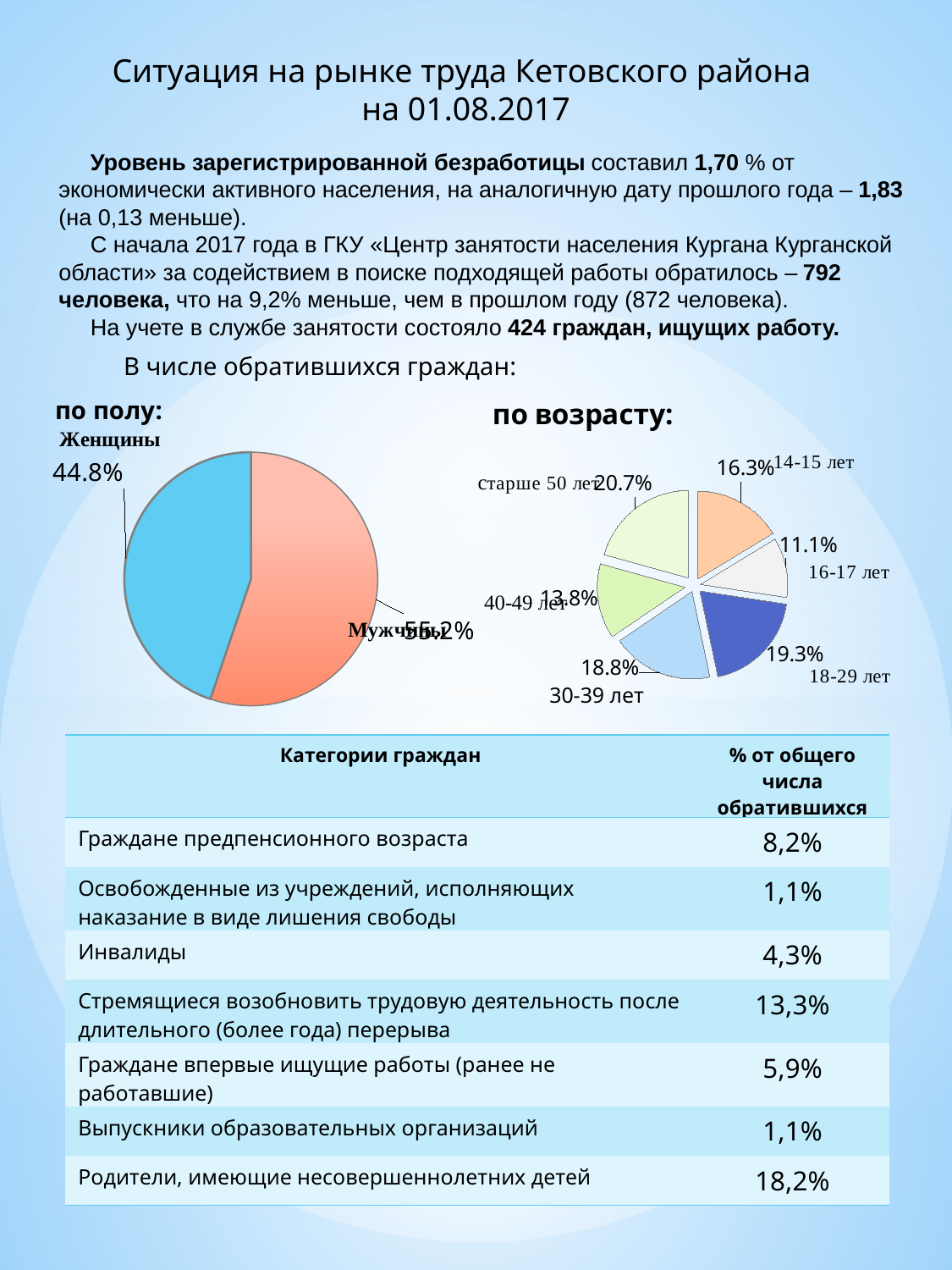
In the 'по полу' pie chart, what share is shown for Мужчины? 55.2% In the 'по возрасту' pie chart, what share is shown for 18-29 лет? 19.3% In the 'по возрасту' pie chart, what share is shown for старше 50 лет? 20.7% In the 'по возрасту' pie chart, which age group has the smallest share? 16-17 лет In the 'по возрасту' pie chart, what share is shown for 14-15 лет? 16.3% What type of chart is the 'по полу' chart? Pie chart How many age groups are shown in the 'по возрасту' pie chart? 6 In the 'по полу' pie chart, which slice is larger, Женщины or Мужчины? Мужчины In the 'по возрасту' pie chart, which age group has the largest share? старше 50 лет In the 'по полу' pie chart, what share is shown for Женщины? 44.8% In the 'по возрасту' pie chart, what is the difference between the shares for 18-29 лет and 30-39 лет? 0.5% How many slices does the 'по полу' pie chart have? 2